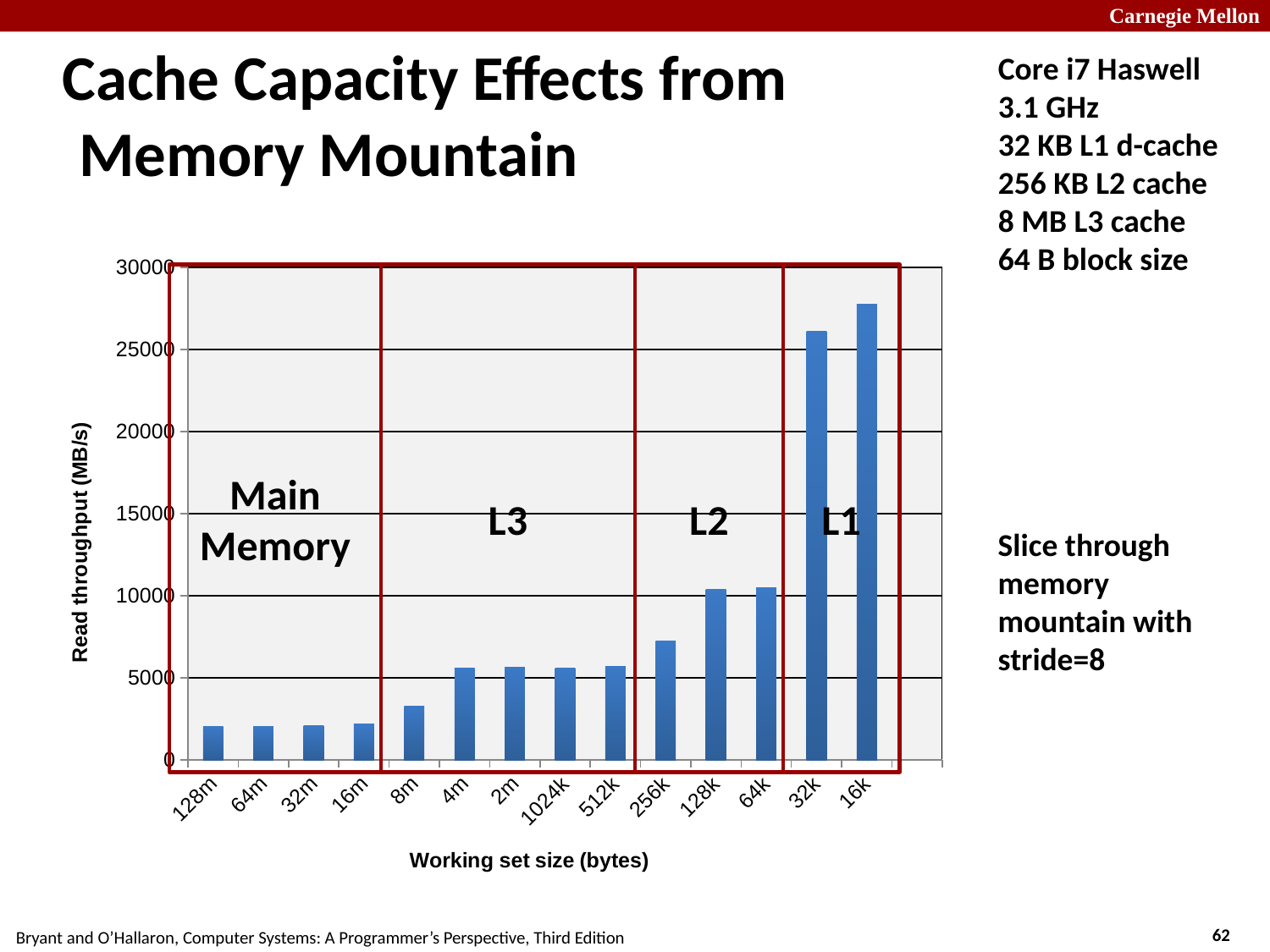
What kind of chart is shown on the slide? bar chart Is the read throughput for a working set size of 4m greater or less than 5000 MB/s? greater Which working set size has the highest read throughput? 16k What is the label of the y axis? Read throughput (MB/s) Do the read throughput values generally rise or fall moving from left to right along the x axis? rise Is the read throughput for a working set size of 8m greater or less than 5000 MB/s? less Is the read throughput for a working set size of 128k greater or less than 15000 MB/s? less Which has the higher read throughput, a working set size of 32k or 16k? 16k Which has the higher read throughput, a working set size of 256k or 512k? 256k How many working set sizes are plotted along the x axis? 14